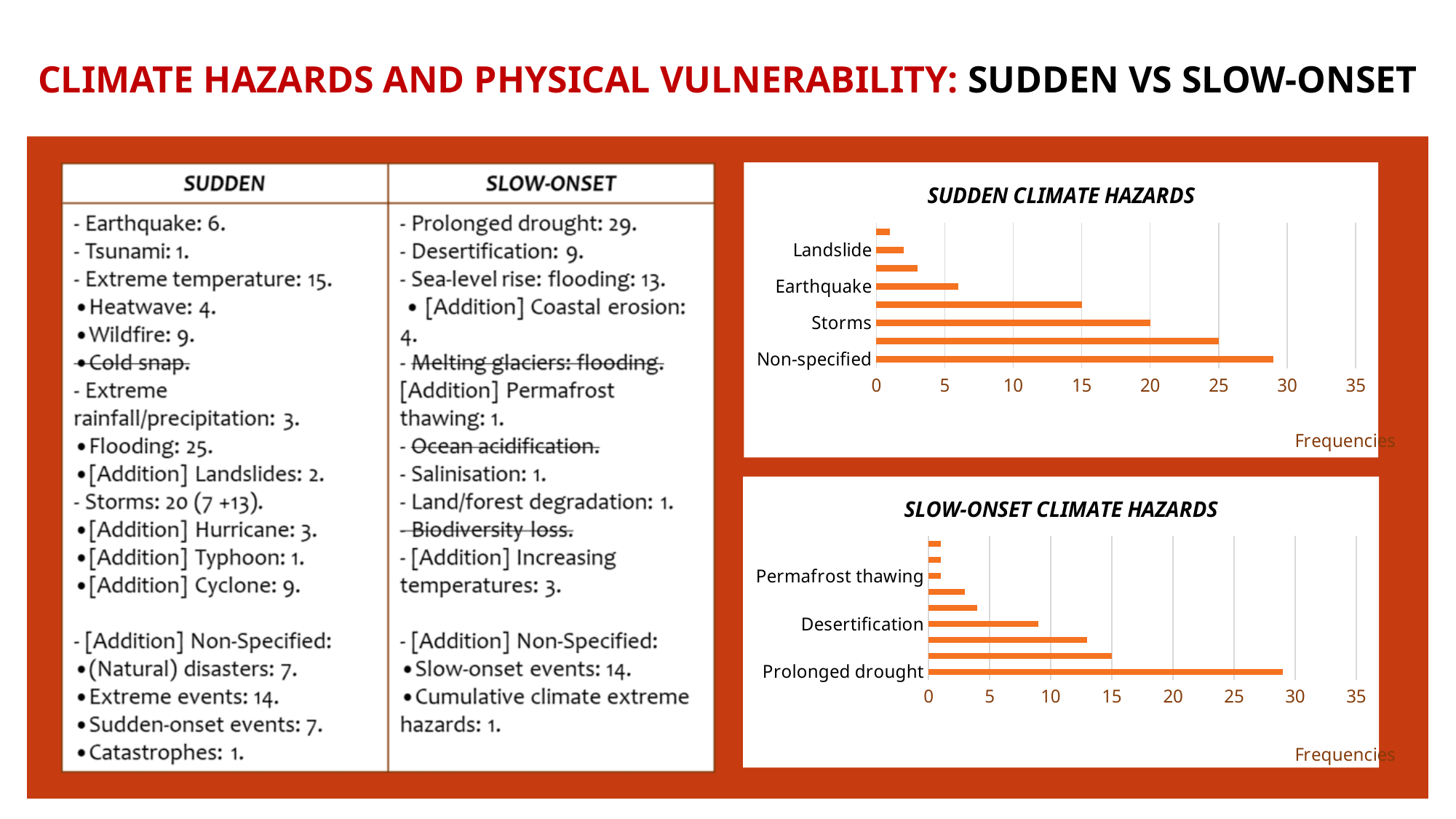
How many bars are plotted in the SLOW-ONSET CLIMATE HAZARDS chart? 9 What is the label shown on the horizontal axis of the SLOW-ONSET CLIMATE HAZARDS chart? Frequencies In the SLOW-ONSET CLIMATE HAZARDS chart, is the value for Desertification greater or less than 10? less In the SLOW-ONSET CLIMATE HAZARDS chart, which labelled category has the longest bar? Prolonged drought What kind of chart is the SUDDEN CLIMATE HAZARDS chart? Bar chart How many bars are plotted in the SUDDEN CLIMATE HAZARDS chart? 8 In the SLOW-ONSET CLIMATE HAZARDS chart, is the value for Prolonged drought greater or less than 25? greater In the SUDDEN CLIMATE HAZARDS chart, is the value for Non-specified greater or less than 25? greater In the SUDDEN CLIMATE HAZARDS chart, which is larger, the value for Storms or the value for Earthquake? Storms In the SUDDEN CLIMATE HAZARDS chart, which labelled category has the longest bar? Non-specified In the SLOW-ONSET CLIMATE HAZARDS chart, which is larger, the value for Desertification or the value for Permafrost thawing? Desertification